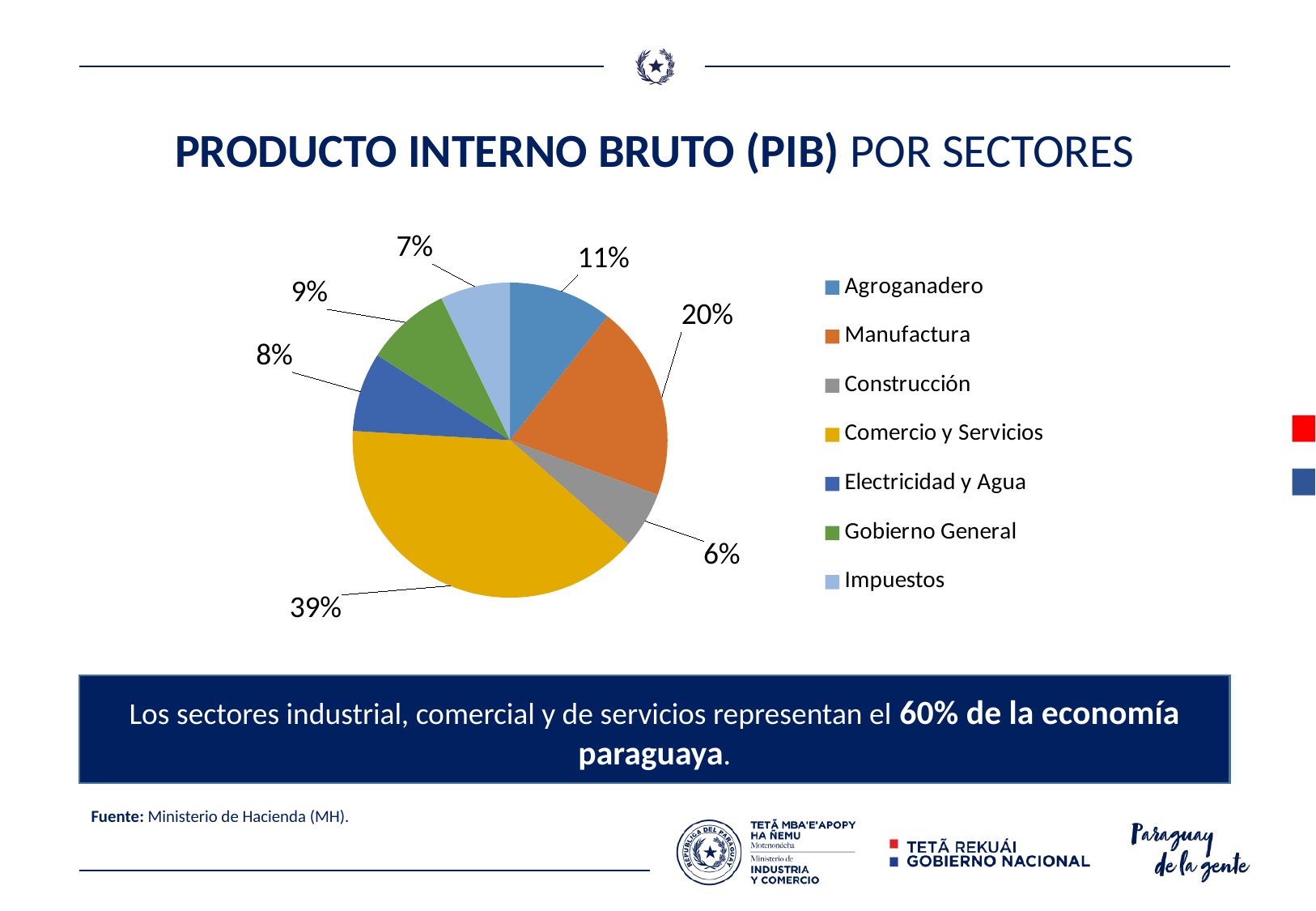
What is the title of the slide containing the chart? PRODUCTO INTERNO BRUTO (PIB) POR SECTORES What is the value shown for Impuestos? 7% Which sector has the smallest share of the pie? Construcción Which sector has the largest share of the pie? Comercio y Servicios What is the value shown for Manufactura? 20% Which is larger, the share for Gobierno General or the share for Electricidad y Agua? Gobierno General How many sectors are listed in the legend? 7 What share of the pie does Comercio y Servicios represent? 39% What is the difference between the shares of Comercio y Servicios and Manufactura? 19% What is the value shown for Agroganadero? 11% What is the value shown for Construcción? 6% What kind of chart is shown on the slide? pie chart